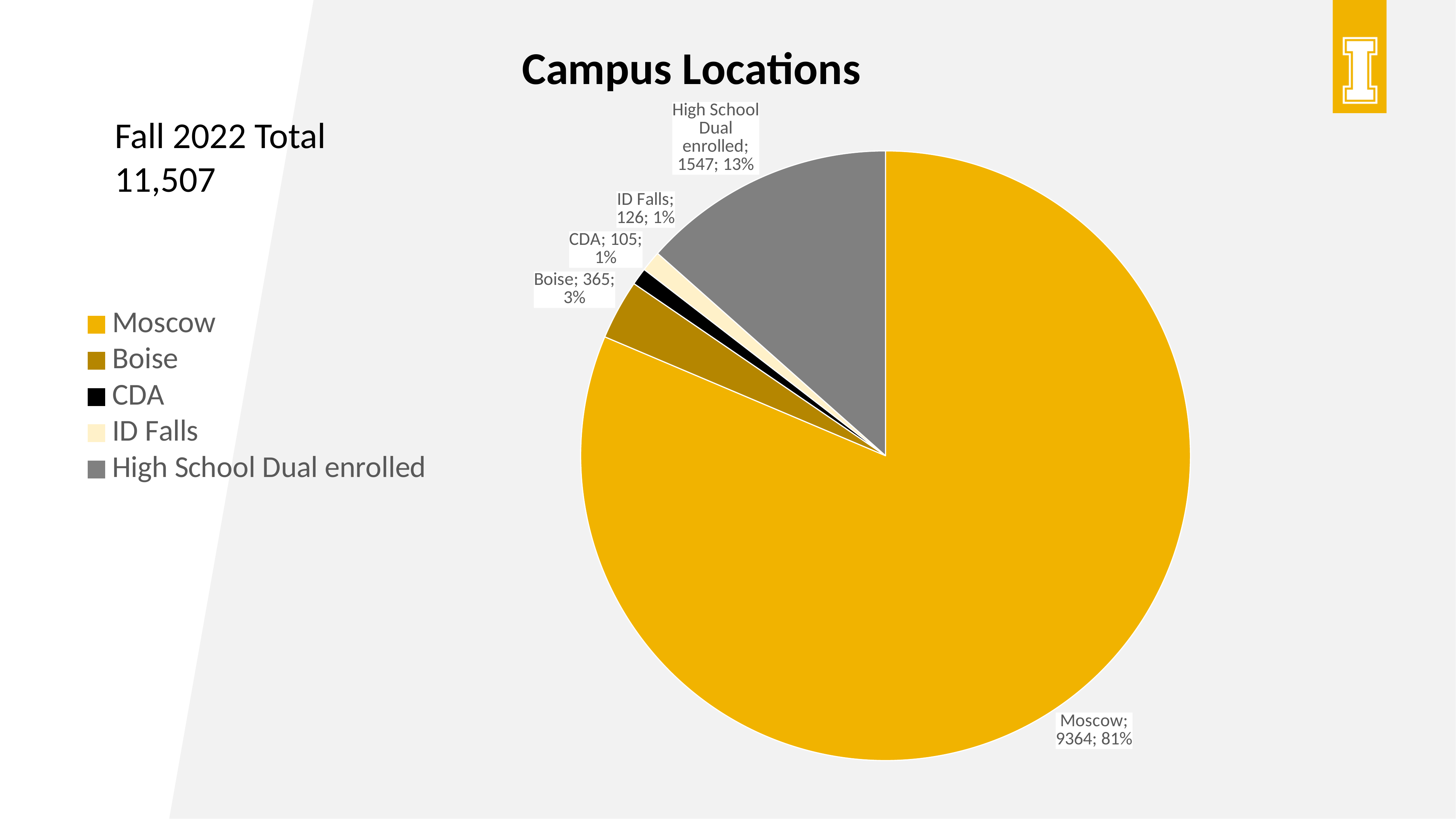
What is the difference between the values for Boise and ID Falls? 239 What type of chart is shown on the slide? Pie chart Which category has the largest slice? Moscow What is the value for Boise? 365 What is the value for Moscow? 9364 What is the value for High School Dual enrolled? 1547 What share of the pie does High School Dual enrolled represent? 13% What is the value for CDA? 105 How many slices does the pie chart have? 5 What is the title of the chart? Campus Locations Which category has the smallest slice? CDA What share of the pie does Moscow represent? 81%